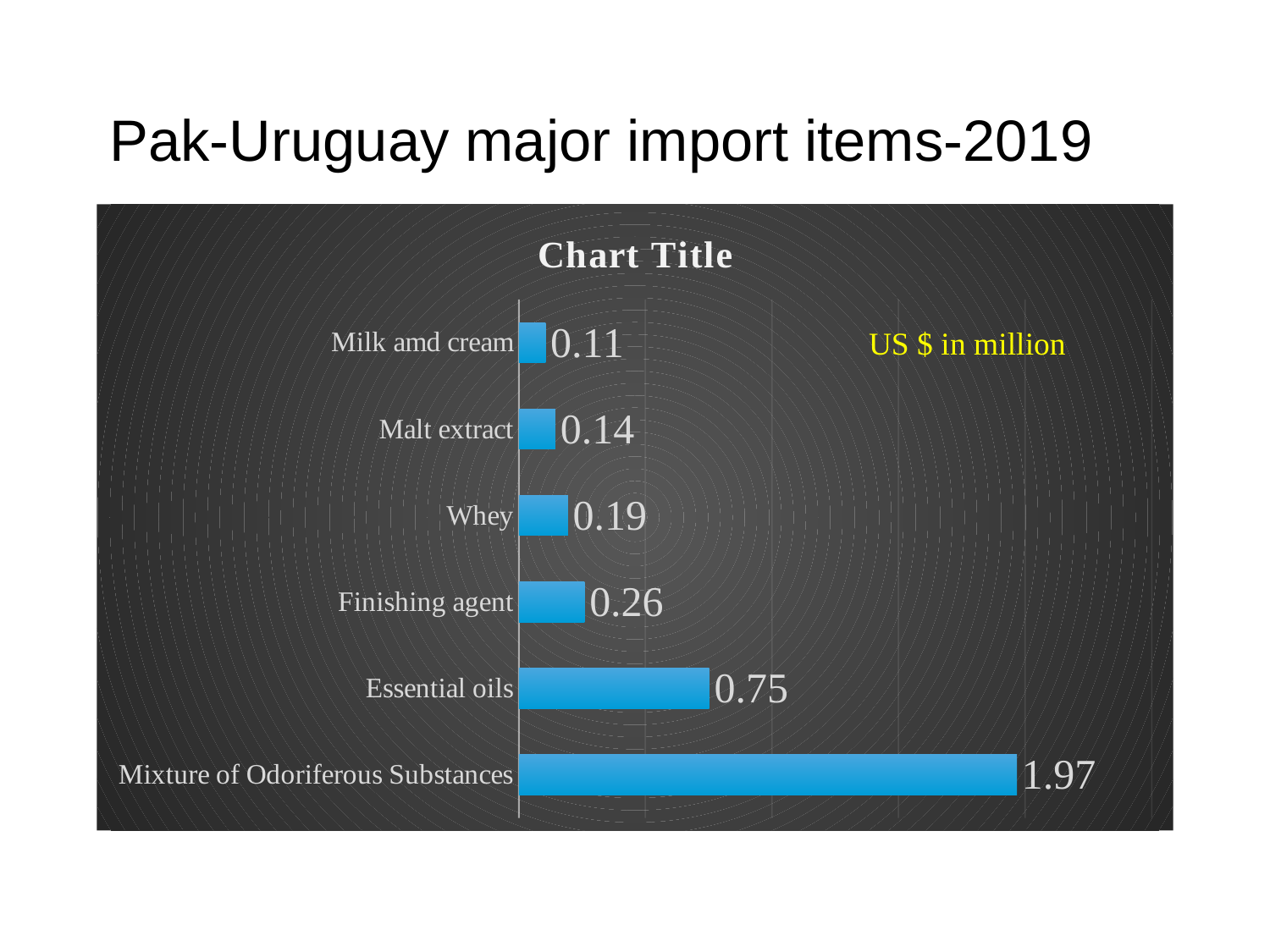
What is the value for Essential oils? 0.75 What is the difference between the values for Mixture of Odoriferous Substances and Essential oils? 1.22 What is the value for Malt extract? 0.14 Which is larger, the value for Finishing agent or the value for Malt extract? Finishing agent What is the difference between the values for Finishing agent and Whey? 0.07 Which category has the highest value? Mixture of Odoriferous Substances What is the title shown above the chart? Chart Title What unit is stated for the values in the chart? US $ in million What is the value for Whey? 0.19 What kind of chart is shown on the slide? Bar chart How many categories are shown in the chart? 6 Which category has the lowest value? Milk amd cream